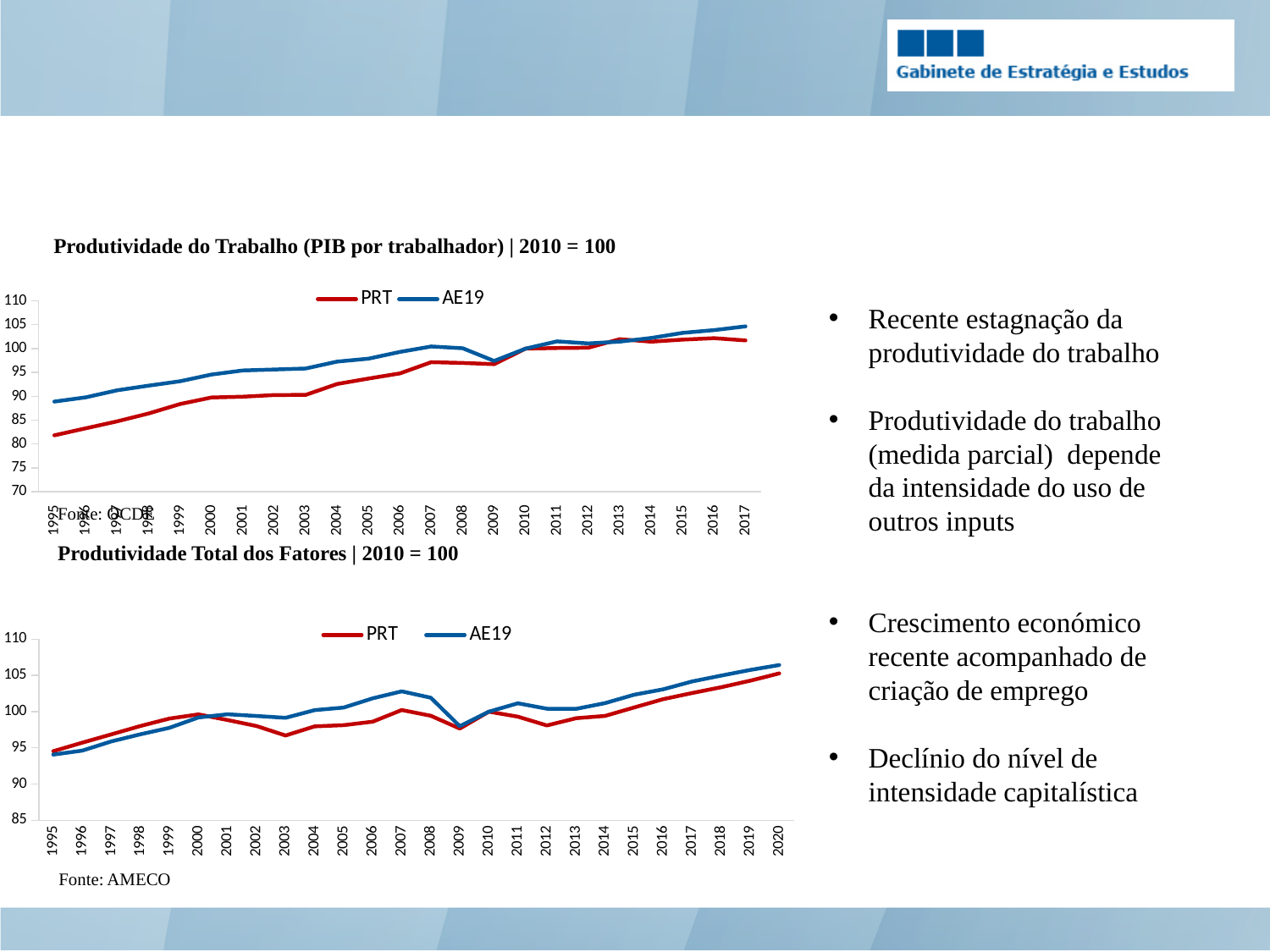
How many series does the legend of the top chart, 'Produtividade do Trabalho', list? 2 In the top chart, 'Produtividade do Trabalho', does the PRT line generally rise or fall from 1995 to 2017? Rise In the top chart, 'Produtividade do Trabalho', is the value for AE19 in 2017 greater or less than 100? greater In the bottom chart, 'Produtividade Total dos Fatores', is the value for AE19 in 2020 greater or less than 105? greater In the top chart, 'Produtividade do Trabalho', is the value for PRT in 1995 greater or less than 85? less How many years are shown on the x axis of the bottom chart, 'Produtividade Total dos Fatores | 2010 = 100'? 26 In the top chart, 'Produtividade do Trabalho', which two series are shown in the legend? PRT and AE19 In the bottom chart, 'Produtividade Total dos Fatores', which series has the higher value in 2007, PRT or AE19? AE19 What source is cited below the bottom chart, 'Produtividade Total dos Fatores'? AMECO What kind of chart is the top chart, 'Produtividade do Trabalho (PIB por trabalhador) | 2010 = 100'? Line chart In the top chart, 'Produtividade do Trabalho', which series has the higher value in 1995, PRT or AE19? AE19